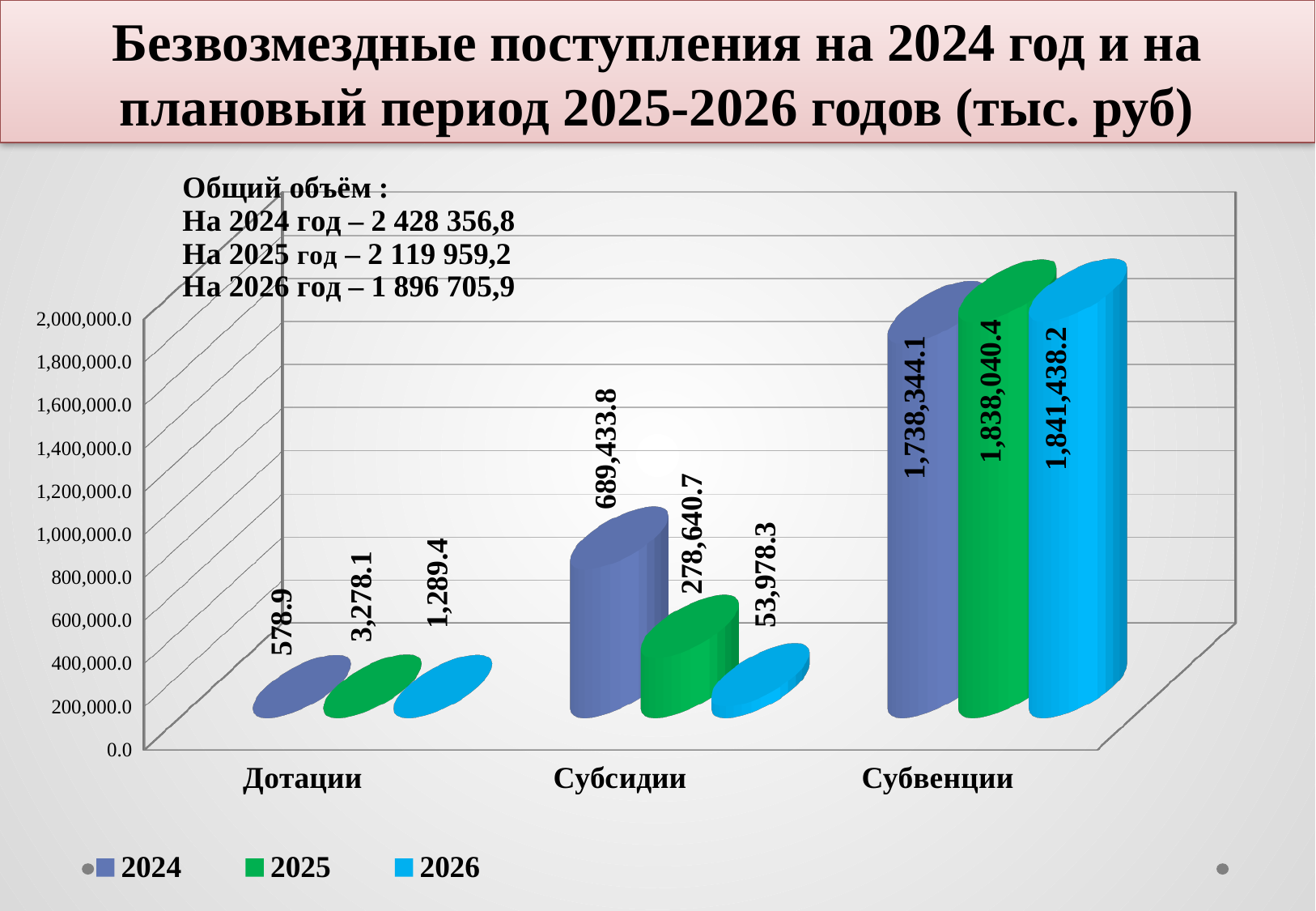
Which category has the lowest value for the 2026 series? Дотации What is the difference between the 2024 and 2025 values for Субсидии? 410,793.1 How many categories are shown on the x axis? 3 What is the difference between the 2026 and 2025 values for Субвенции? 3,397.8 What is the value for Субвенции in 2026? 1,841,438.2 What is the value for Дотации in 2025? 3,278.1 How many series does the legend list? 3 What kind of chart is shown on the slide? bar chart What is the value for Субсидии in 2026? 53,978.3 Which is larger for Субсидии: the 2024 value or the 2025 value? 2024 Which category has the highest value for the 2024 series? Субвенции What is the value for Субсидии in 2024? 689,433.8